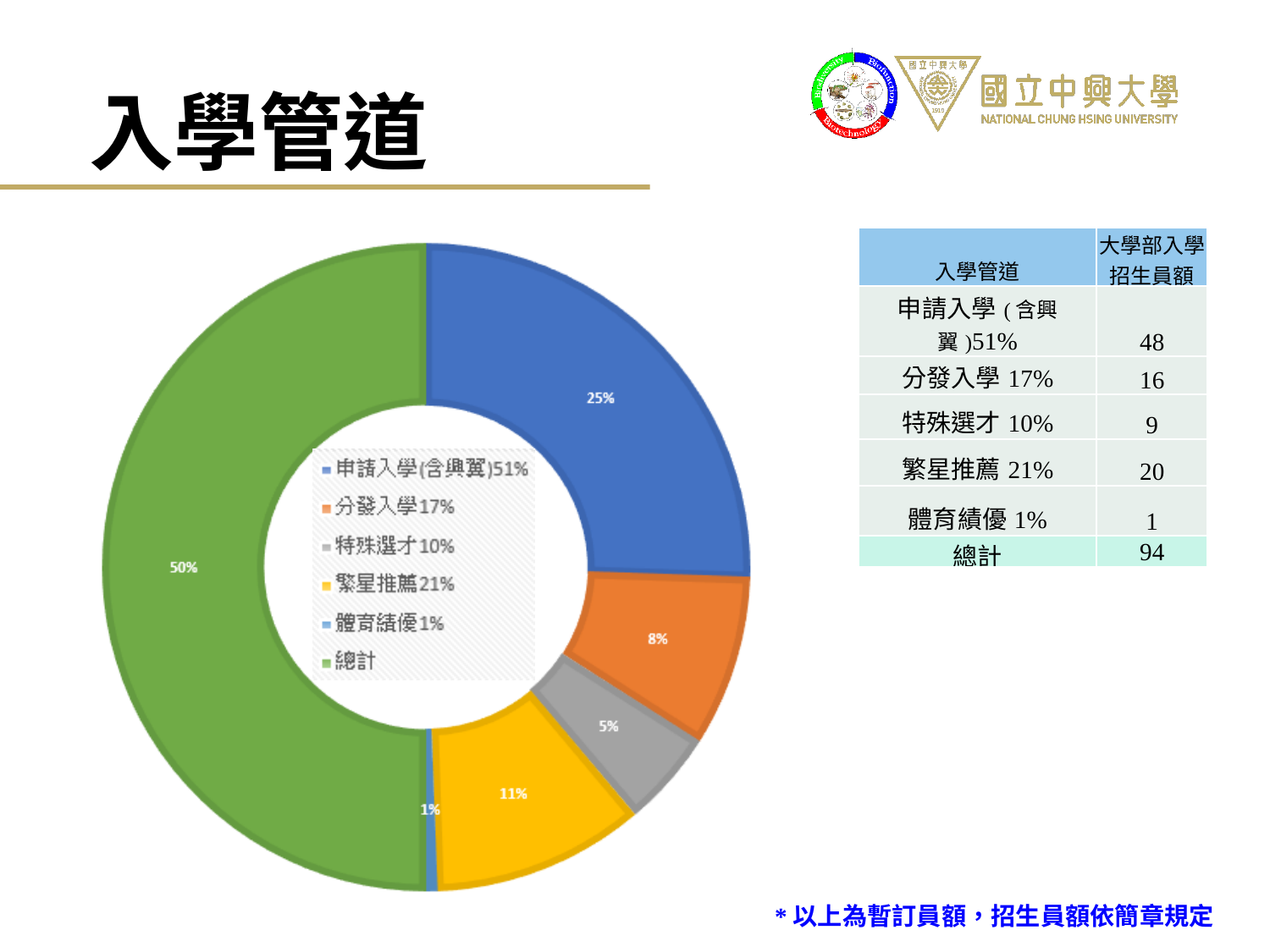
How many slices does the doughnut chart have? 6 What data label is shown on the 申請入學(含興翼) slice of the doughnut chart? 25% Which slice of the chart has the smallest data label? 體育績優 What data label is shown on the 總計 (green) slice of the chart? 50% What percentage is written in the legend entry for 繁星推薦? 21% What is the difference between the data labels of the 申請入學(含興翼) slice and the 分發入學 slice? 17 percentage points What data label is shown on the 特殊選才 slice of the chart? 5% What data label is shown on the 繁星推薦 slice of the chart? 11% Which slice has a larger data label, 繁星推薦 or 分發入學? 繁星推薦 Which slice of the chart has the largest data label? 總計 What data label is shown on the 分發入學 slice of the chart? 8% What kind of chart is shown on the slide? Doughnut (pie) chart